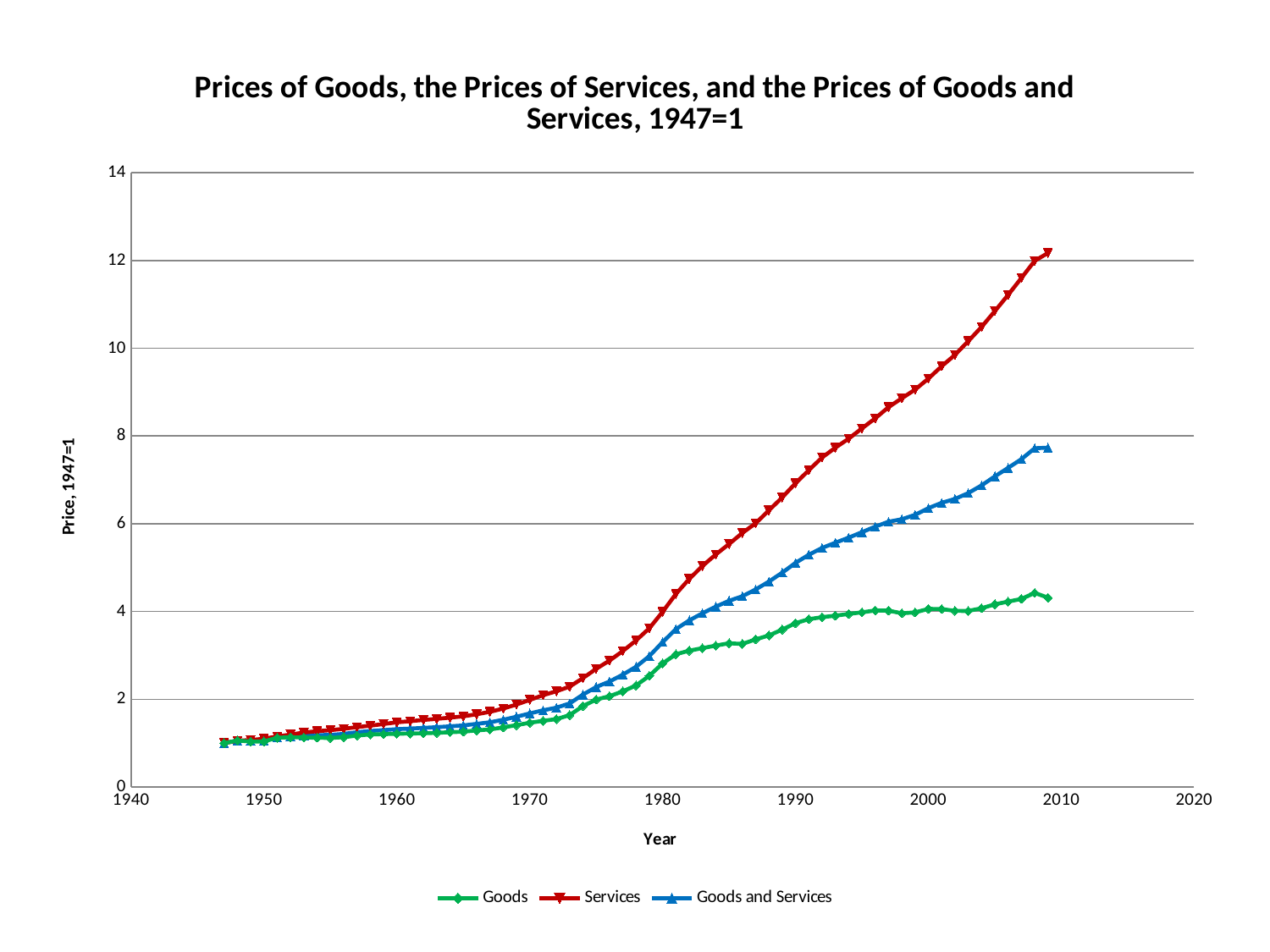
Does the Services series rise or fall from 1947 to 2009? rise In 2000, which is larger: the value for Services or the value for Goods? Services Is the value for Goods in 2000 greater or less than 6? less Which series has the highest value at the right end of the chart (around 2009)? Services Is the value for Services in 2000 greater or less than 8? greater Is the value for Goods in 1970 greater or less than 2? less What is the label of the y axis? Price, 1947=1 Which colour is used for the Goods and Services series? blue What kind of chart is shown on the slide? line chart Which series has the lowest value at the right end of the chart (around 2009)? Goods How many series does the legend list? 3